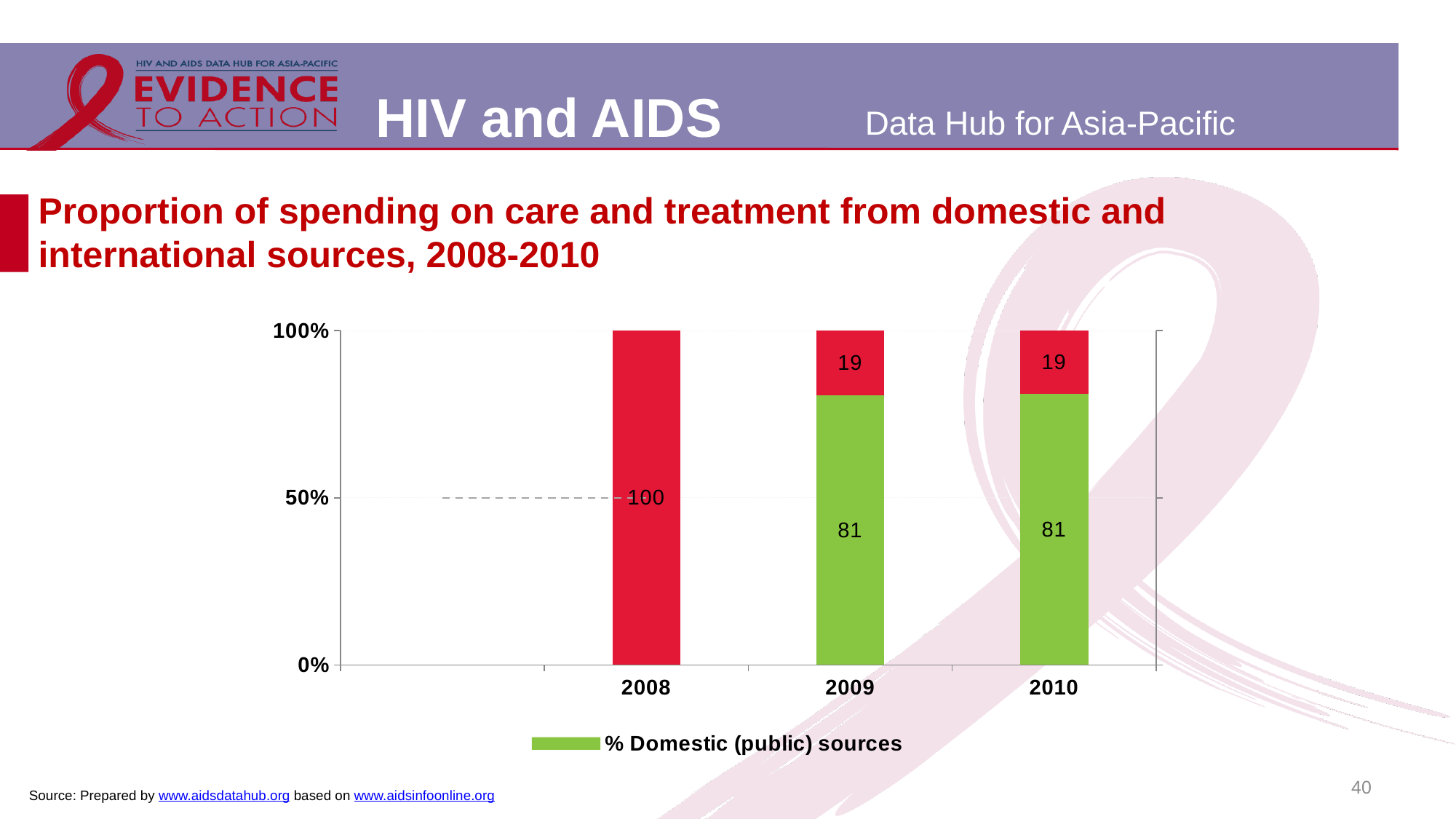
What is the value for % Domestic (public) sources in 2010? 81 What is the value for % Domestic (public) sources in 2009? 81 How many series does the chart's legend list? 1 What is the total of the stacked bar for 2009? 100 What kind of chart is shown on the slide? stacked bar chart Which colour represents % Domestic (public) sources in the chart? green What value is printed on the red segment of the 2009 bar? 19 Is the value for % Domestic (public) sources in 2009 greater or less than 50%? greater What series name is shown in the chart's legend? % Domestic (public) sources How many years are shown on the x axis of the chart? 3 What value is printed on the 2008 bar? 100 What is the difference between the green and red segments of the 2010 bar? 62